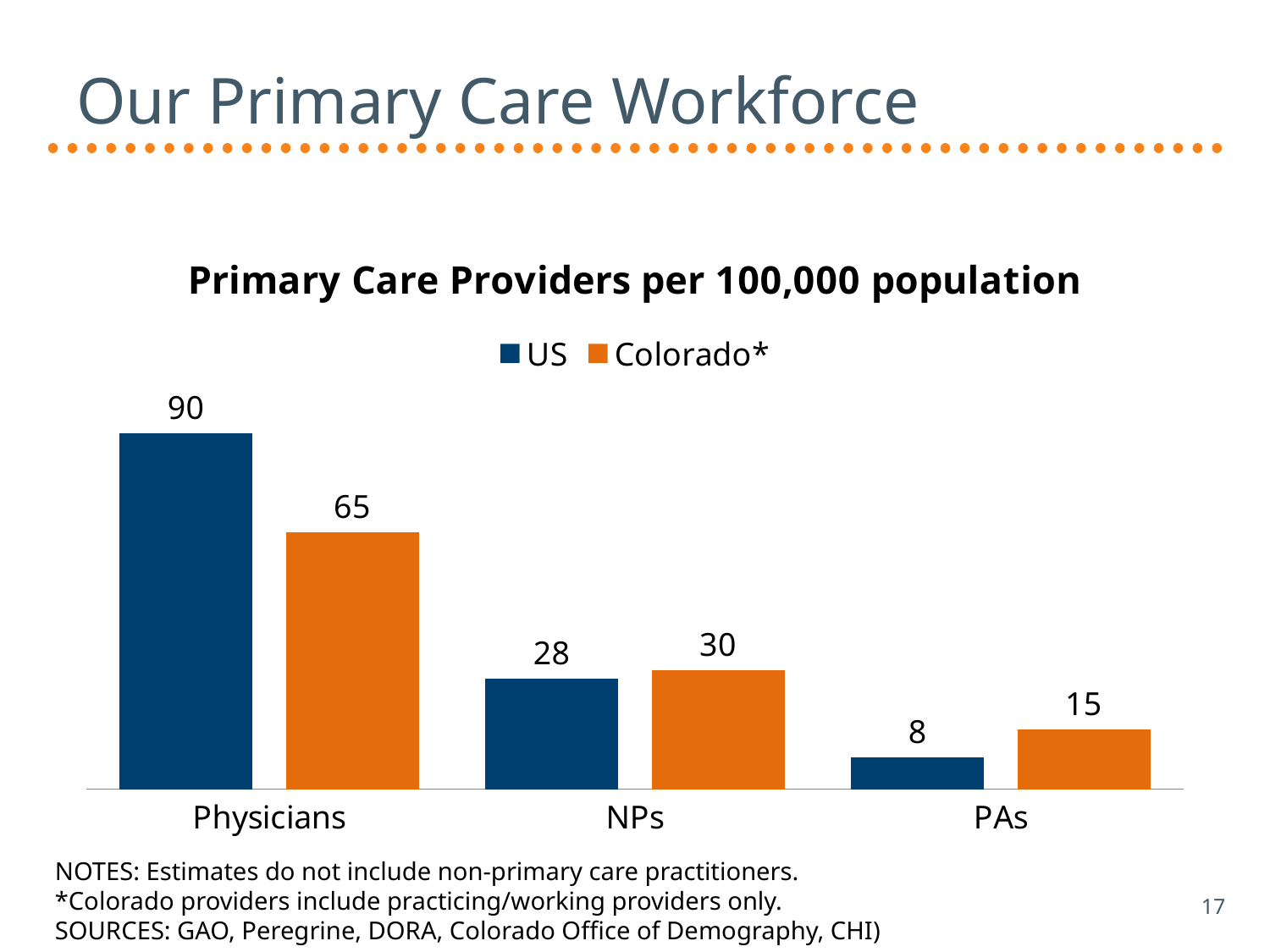
What is the difference between the Colorado* and US values for PAs? 7 What is the US value for PAs? 8 Which is larger for NPs, the US value or the Colorado* value? Colorado* What is the Colorado* value for Physicians? 65 Which category has the lowest Colorado* value? PAs What is the difference between the US and Colorado* values for Physicians? 25 What is the Colorado* value for NPs? 30 What is the US value for Physicians? 90 Which category has the highest US value? Physicians How many categories are shown on the x axis? 3 How many series does the legend list? 2 What kind of chart is shown on the slide? Bar chart